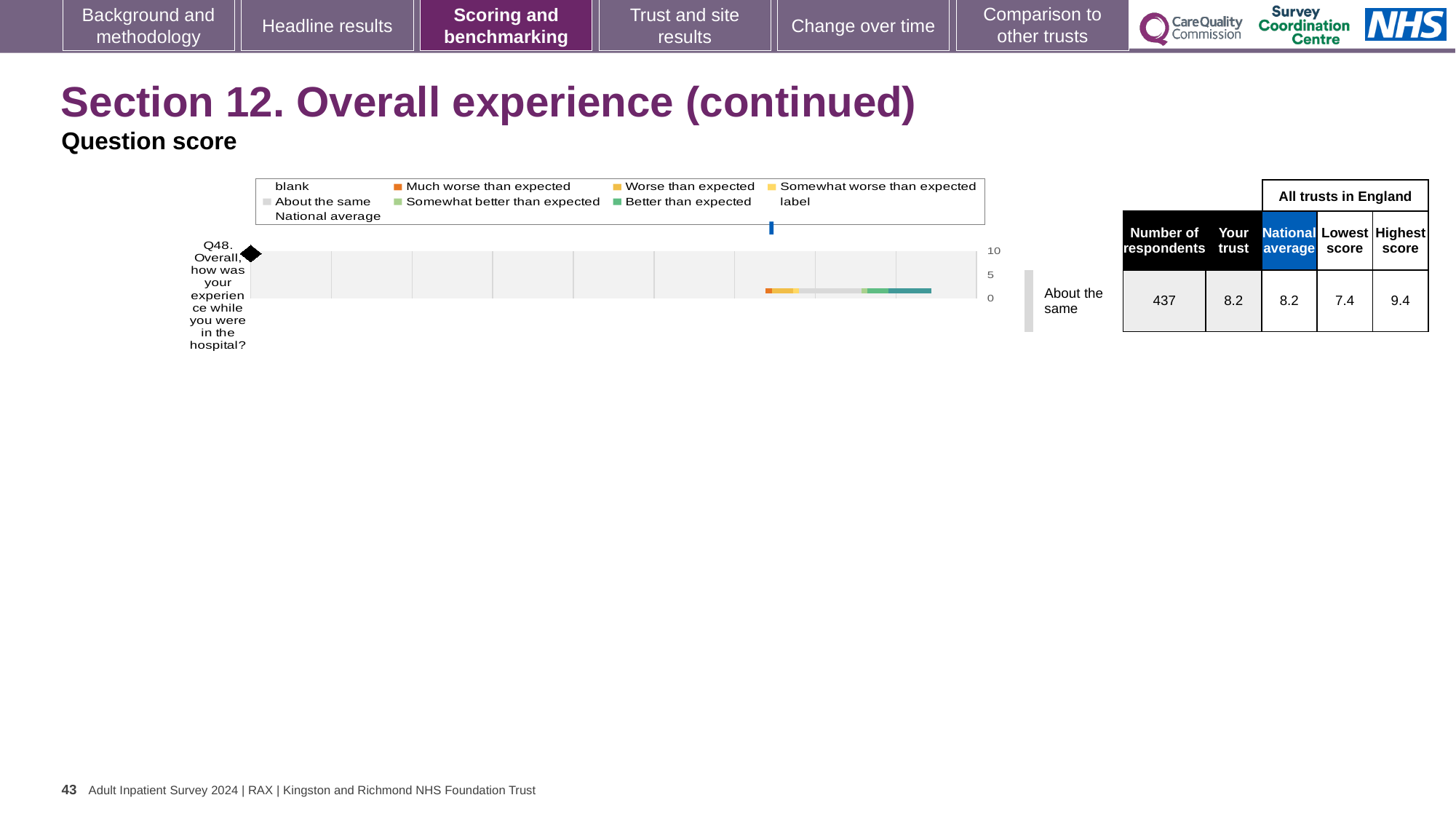
How many respondents answered Q48? 437 Which question is plotted on the chart? Q48. Overall, how was your experience while you were in the hospital? What is the highest score among all trusts in England for Q48? 9.4 What is the 'Your trust' score for Q48? 8.2 Is the 'Your trust' score for Q48 greater or less than 5? greater What is the lowest score among all trusts in England for Q48? 7.4 Which benchmarking band is the trust's Q48 result placed in? About the same What is the difference between the highest and lowest scores among all trusts in England for Q48? 2.0 What is the highest value shown on the chart's axis? 10 What kind of chart is shown on the slide? bar chart How many questions (categories) are plotted on the chart? 1 What is the national average score for Q48? 8.2